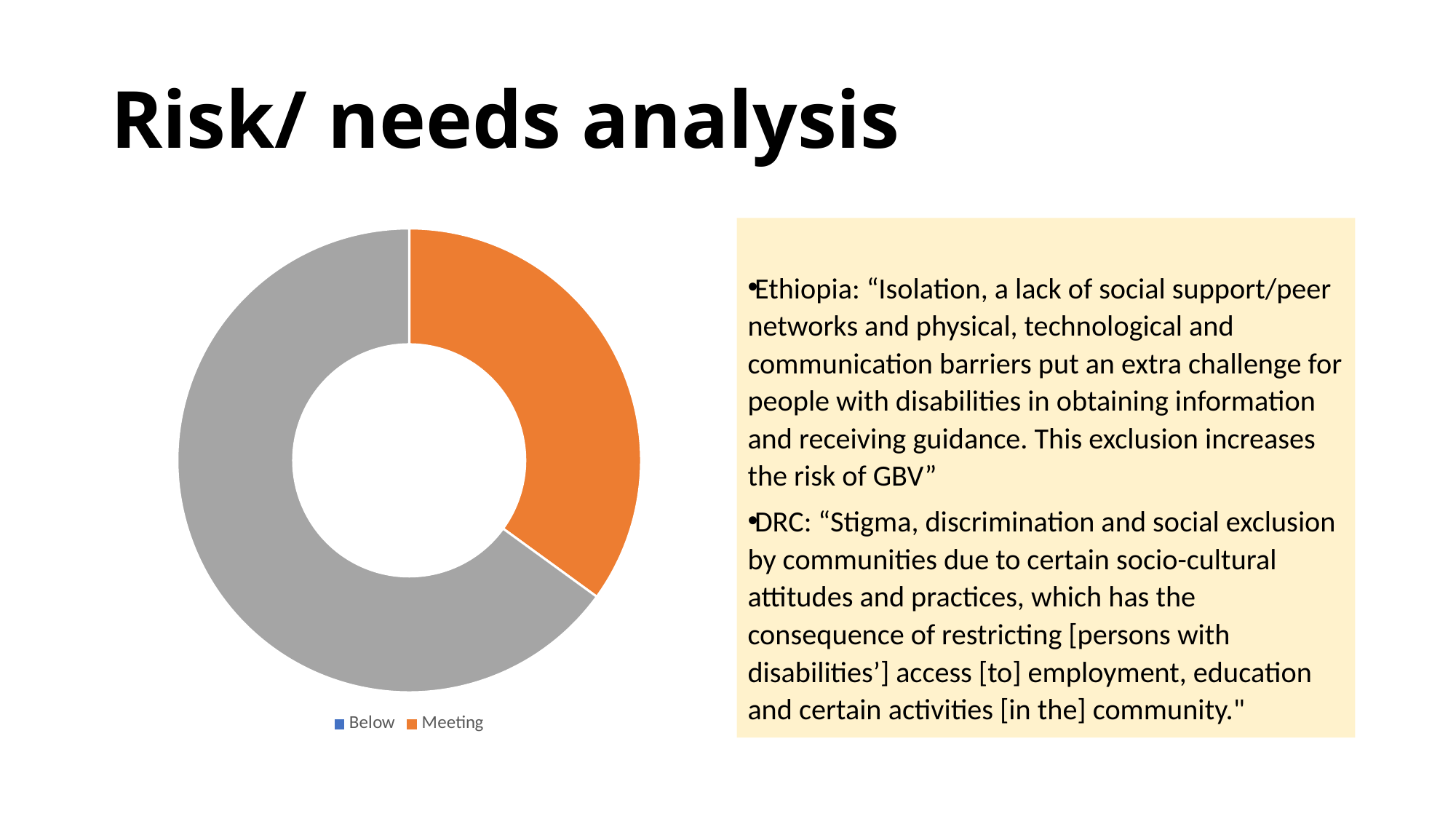
Does the grey slice take up more or less than half of the doughnut? more Does the Meeting slice take up more or less than a quarter of the doughnut? more Which slice of the doughnut is larger, the orange one or the grey one? the grey one What are the two entries listed in the chart legend? Below and Meeting How many entries does the chart legend list? 2 What colour is the Meeting slice in the chart? orange Does the Meeting slice take up more or less than half of the doughnut? less What kind of chart is shown on the slide? doughnut chart How many slices does the doughnut chart have? 2